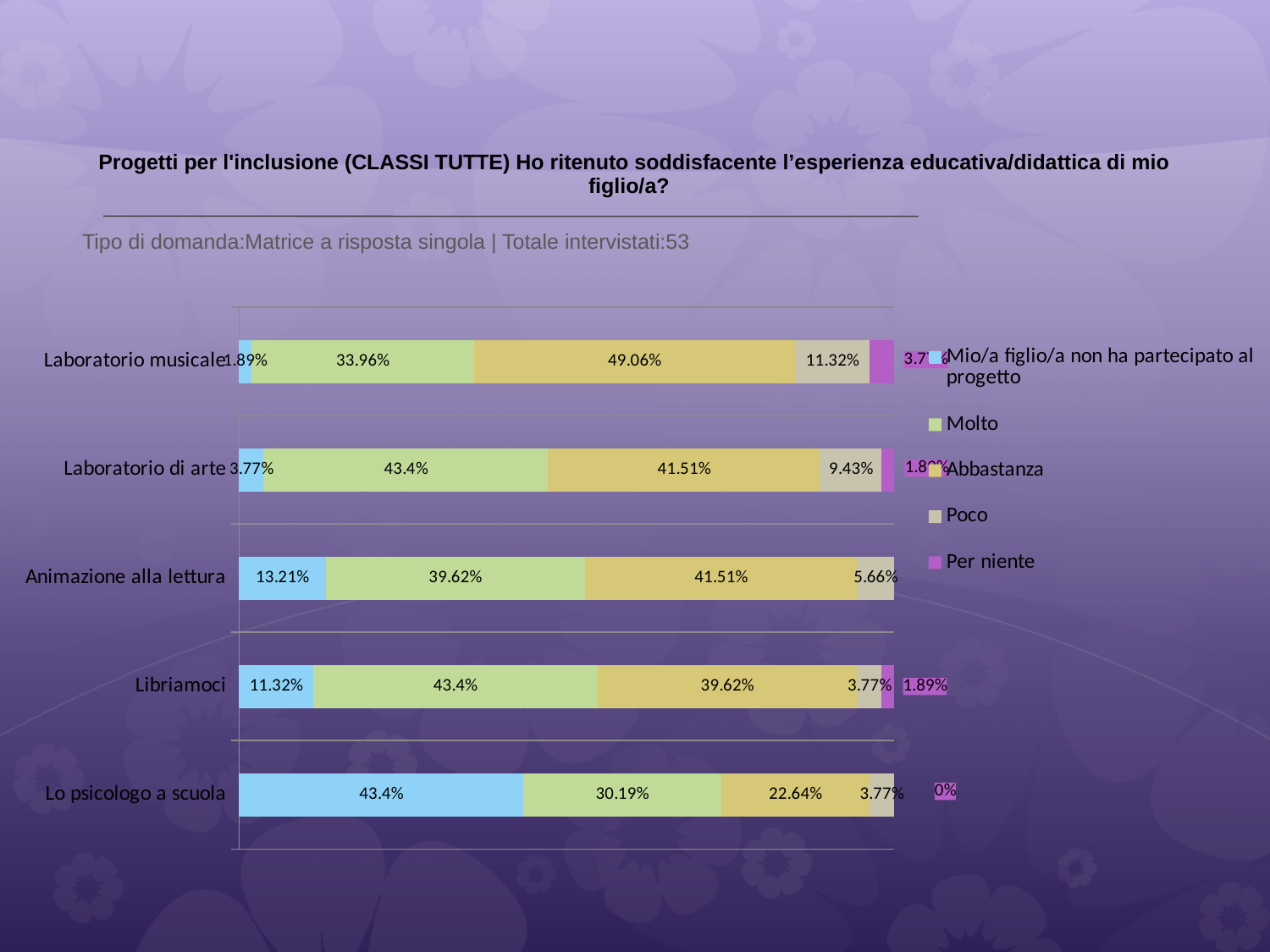
Which is larger: the 'Mio/a figlio/a non ha partecipato al progetto' value for Animazione alla lettura or for Libriamoci? Animazione alla lettura How many series does the legend list? 5 How many projects (categories) are listed on the vertical axis of the chart? 5 What is the total number of respondents stated in the subtitle of the chart? 53 Which project has the highest 'Abbastanza' value? Laboratorio musicale Which project has the lowest 'Molto' value? Lo psicologo a scuola What is the 'Mio/a figlio/a non ha partecipato al progetto' value for Lo psicologo a scuola? 43.4% What type of chart is shown on the slide? Stacked bar chart What is the 'Molto' value for Laboratorio di arte? 43.4% What is the difference between the 'Poco' values for Laboratorio musicale and Libriamoci? 7.55% What is the 'Poco' value for Animazione alla lettura? 5.66% What is the 'Abbastanza' value for Laboratorio musicale? 49.06%